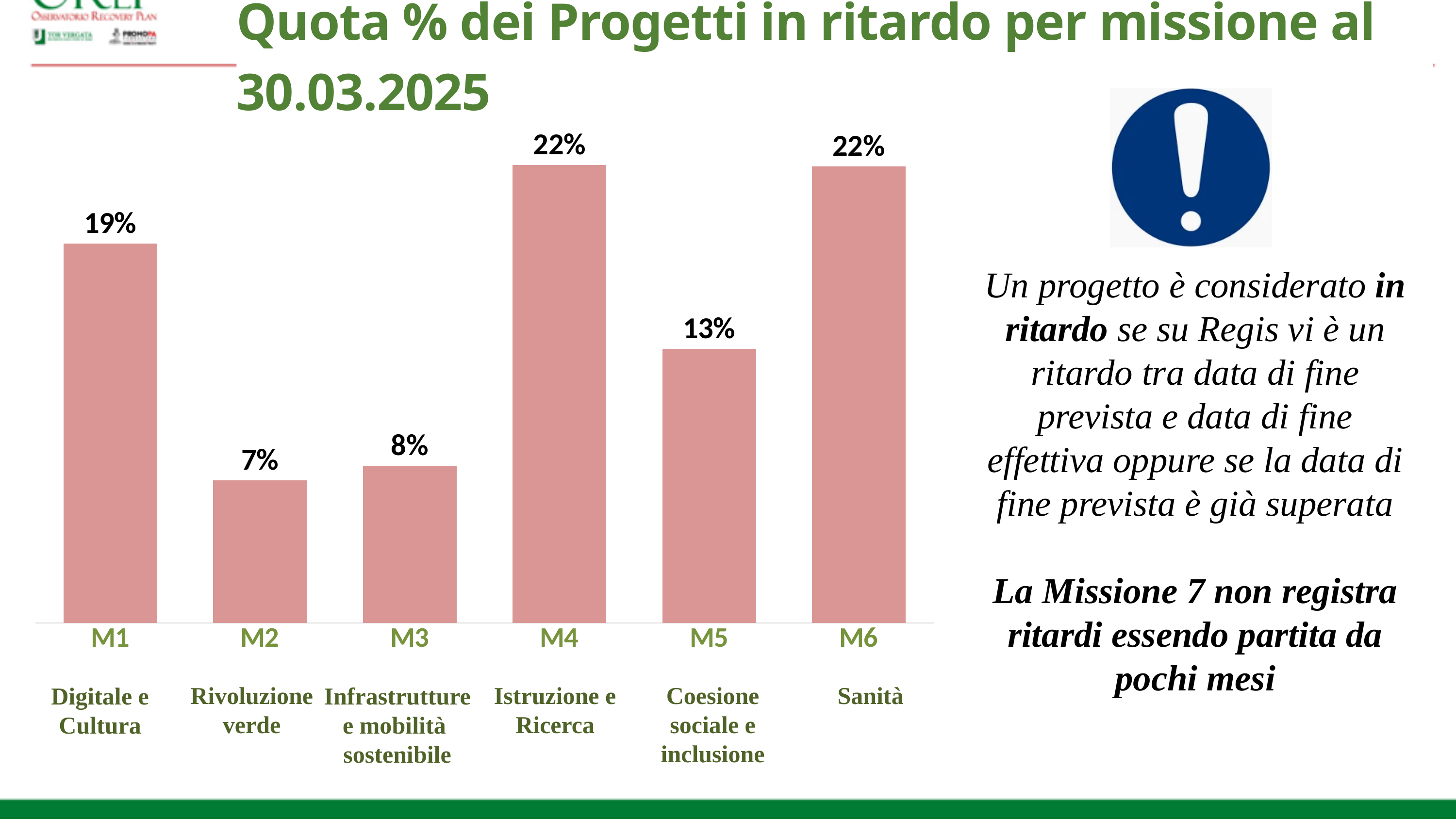
Which is larger, the value for M3 or the value for M5? M5 What is the value for M1 (Digitale e Cultura)? 19% What is the value for M5 (Coesione sociale e inclusione)? 13% What is the value for M2 (Rivoluzione verde)? 7% What is the difference between the values for M4 and M5? 9% What kind of chart is shown on the slide? Bar chart What is the value for M6 (Sanità)? 22% Which two missions share the highest value of 22%? M4 and M6 What is the title of the chart? Quota % dei Progetti in ritardo per missione al 30.03.2025 What is the difference between the values for M1 and M3? 11% Which mission has the lowest share of delayed projects? M2 How many missions are shown in the chart? 6